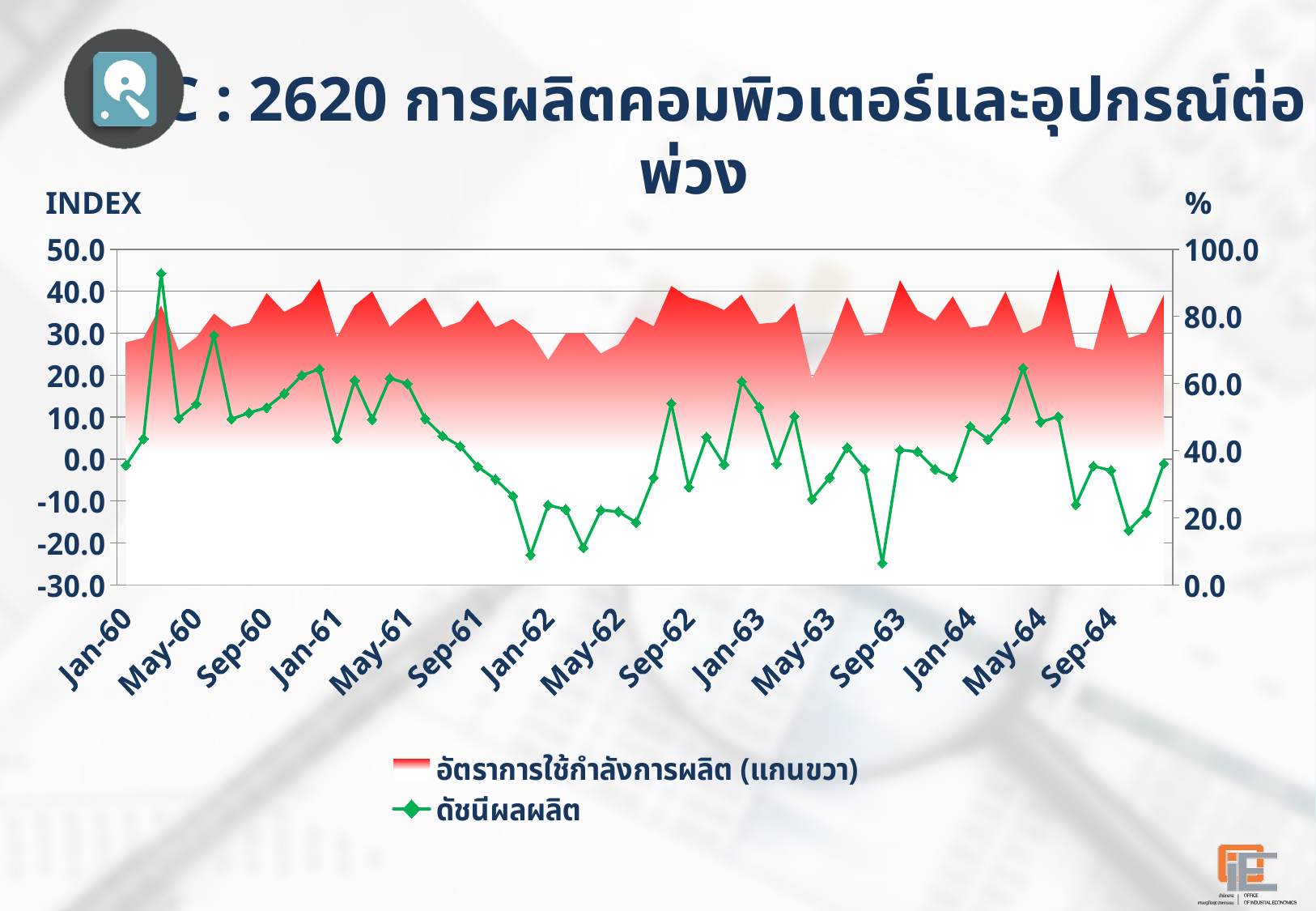
Is the value of ดัชนีผลผลิต at Sep-63 greater or less than -10.0? greater Is the value of อัตราการใช้กำลังการผลิต at Jan-60 greater or less than 60.0? greater Which is larger for ดัชนีผลผลิต, the value at Jan-62 or the value at Sep-62? Sep-62 Does ดัชนีผลผลิต rise or fall between Jan-61 and Jan-62? fall How many series does the legend list? 2 Is the value of ดัชนีผลผลิต at May-60 greater or less than 0.0? greater What is the first month shown on the x axis? Jan-60 Does ดัชนีผลผลิต rise or fall between Jan-62 and Sep-62? rise What kind of chart is this? A combination of an area chart and a line chart Which series is plotted against the right axis according to the legend? อัตราการใช้กำลังการผลิต (แกนขวา) What is the label of the left vertical axis? INDEX